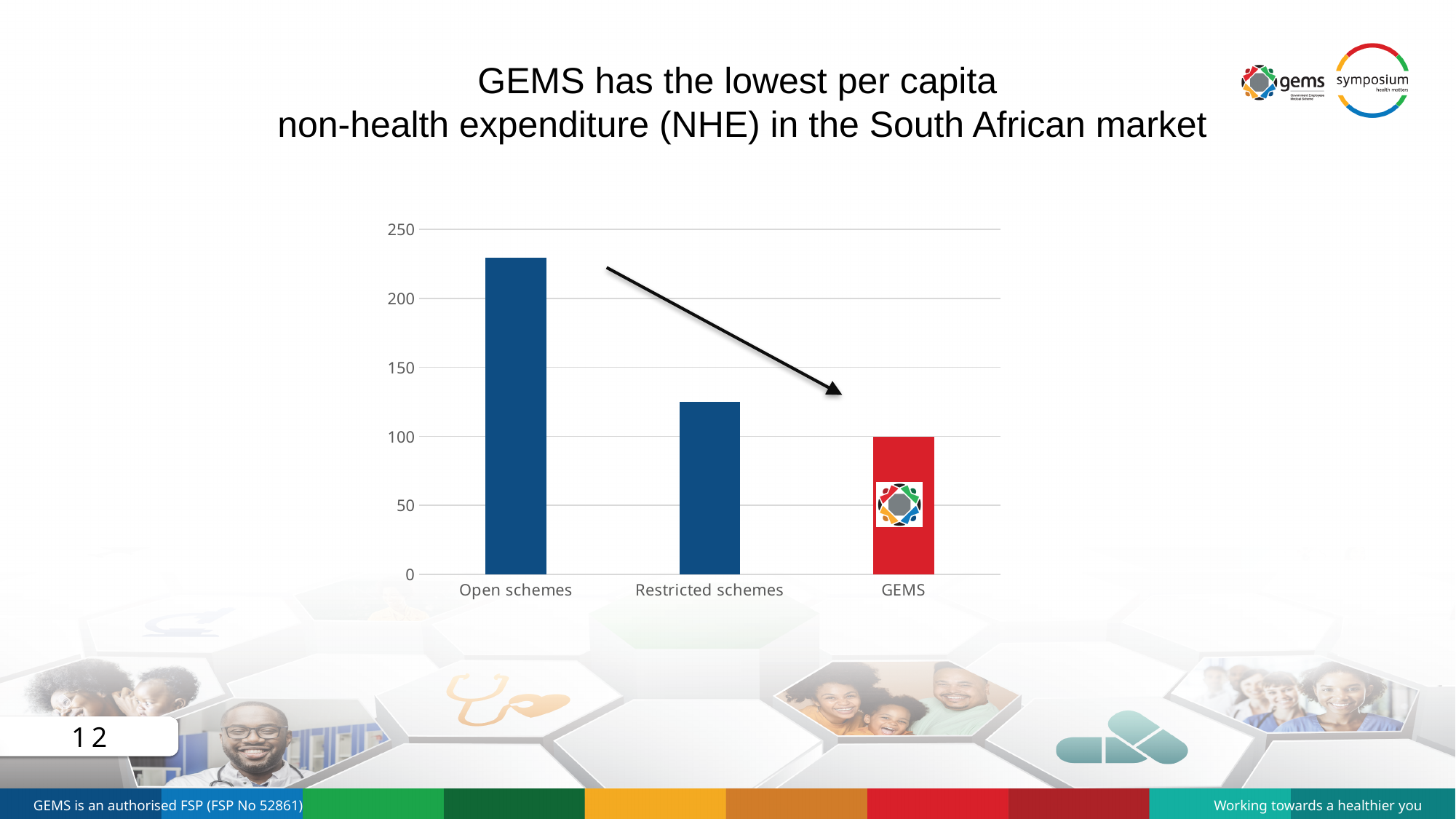
Is the value for Restricted schemes greater or less than 150? less What colour is the GEMS bar on the chart? red Which is larger, the value for Open schemes or the value for Restricted schemes? Open schemes How many categories are plotted on the chart? 3 Which category has the highest value on the chart? Open schemes Is the value for Open schemes greater or less than 250? less Do the values rise or fall from left to right across the categories? fall What kind of chart is shown on the slide? bar chart Which category has the lowest value on the chart? GEMS Is the value for Open schemes greater or less than 200? greater Which is larger, the value for Restricted schemes or the value for GEMS? Restricted schemes